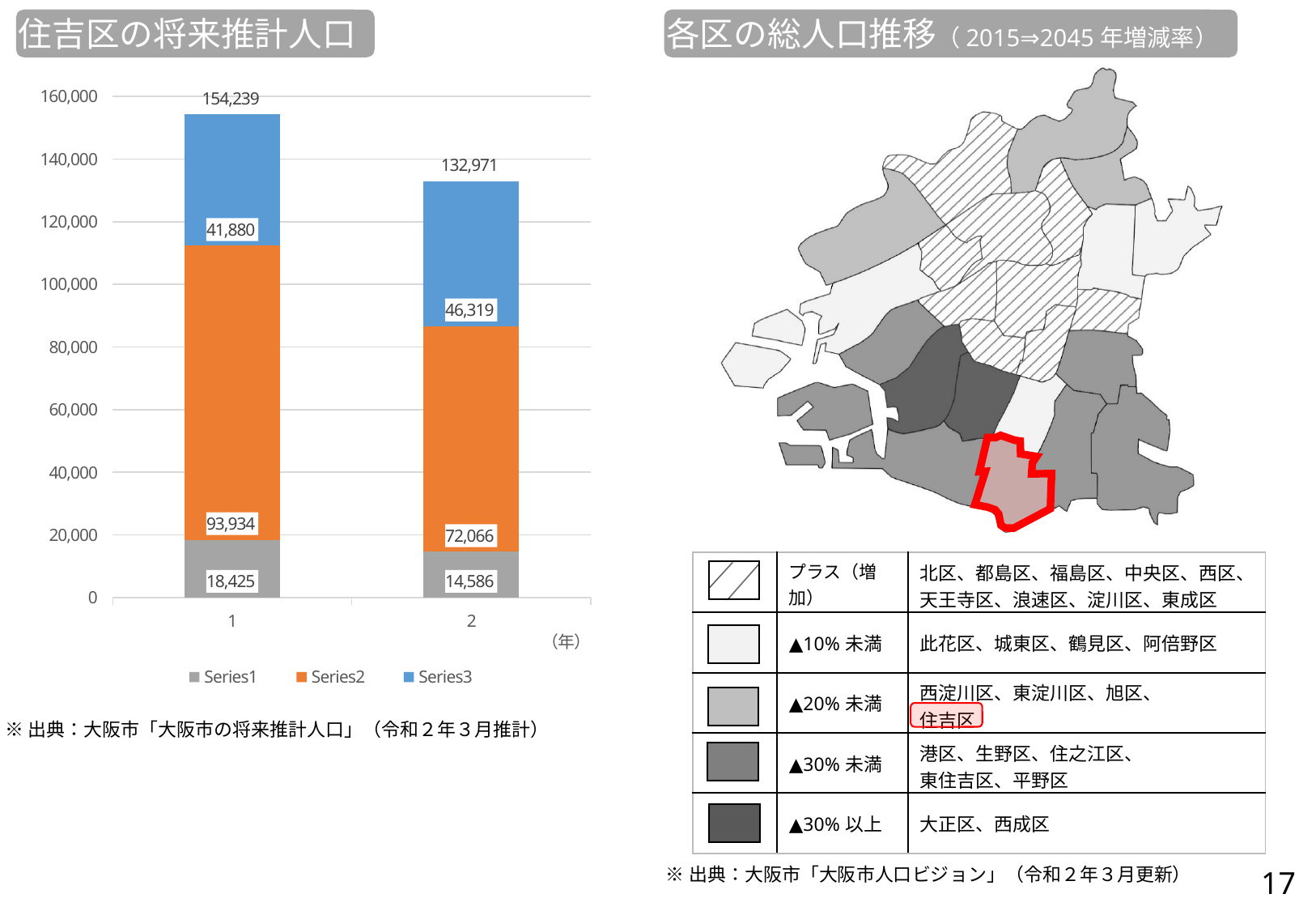
In the chart titled 住吉区の将来推計人口, which category has the larger Series3 value, 1 or 2? 2 In the chart titled 住吉区の将来推計人口, what is the value of Series2 for category 1? 93,934 In the chart titled 住吉区の将来推計人口, what is the difference between the total for category 1 and the total for category 2? 21,268 How many series does the legend of the chart titled 住吉区の将来推計人口 list? 3 In the chart titled 住吉区の将来推計人口, what is the value of Series1 for category 2? 14,586 In the chart titled 住吉区の将来推計人口, what is the total of the stacked bar for category 1? 154,239 In the chart titled 住吉区の将来推計人口, which series has the largest value in category 1? Series2 In the chart titled 住吉区の将来推計人口, what is the value of Series3 for category 1? 41,880 How many categories are shown on the x axis of the chart titled 住吉区の将来推計人口? 2 In the chart titled 住吉区の将来推計人口, what is the total of the stacked bar for category 2? 132,971 What kind of chart is the chart titled 住吉区の将来推計人口? Stacked bar chart In the chart titled 住吉区の将来推計人口, what is the difference between the Series2 values for category 1 and category 2? 21,868